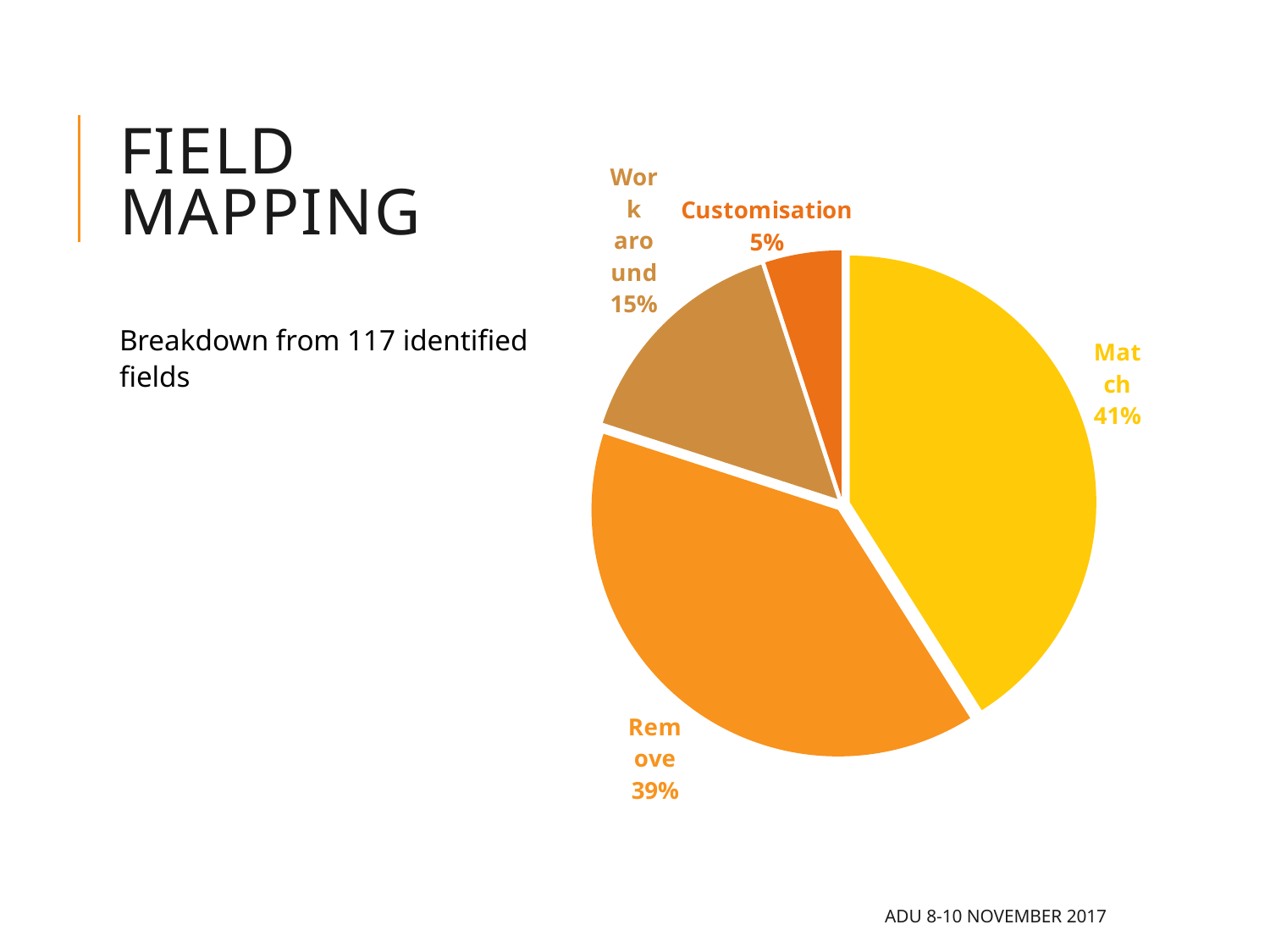
Which is larger, the Workaround slice or the Customisation slice? Workaround Which slice of the pie is the largest? Match What share of the pie does the Customisation slice represent? 5% According to the slide text, how many identified fields does the breakdown cover? 117 What share of the pie does the Workaround slice represent? 15% What is the difference in percentage points between the Workaround and Customisation slices? 10 Which slice of the pie is the smallest? Customisation What share of the pie does the Remove slice represent? 39% What is the difference in percentage points between the Match and Remove slices? 2 What kind of chart is shown on the slide? pie chart How many slices does the pie chart have? 4